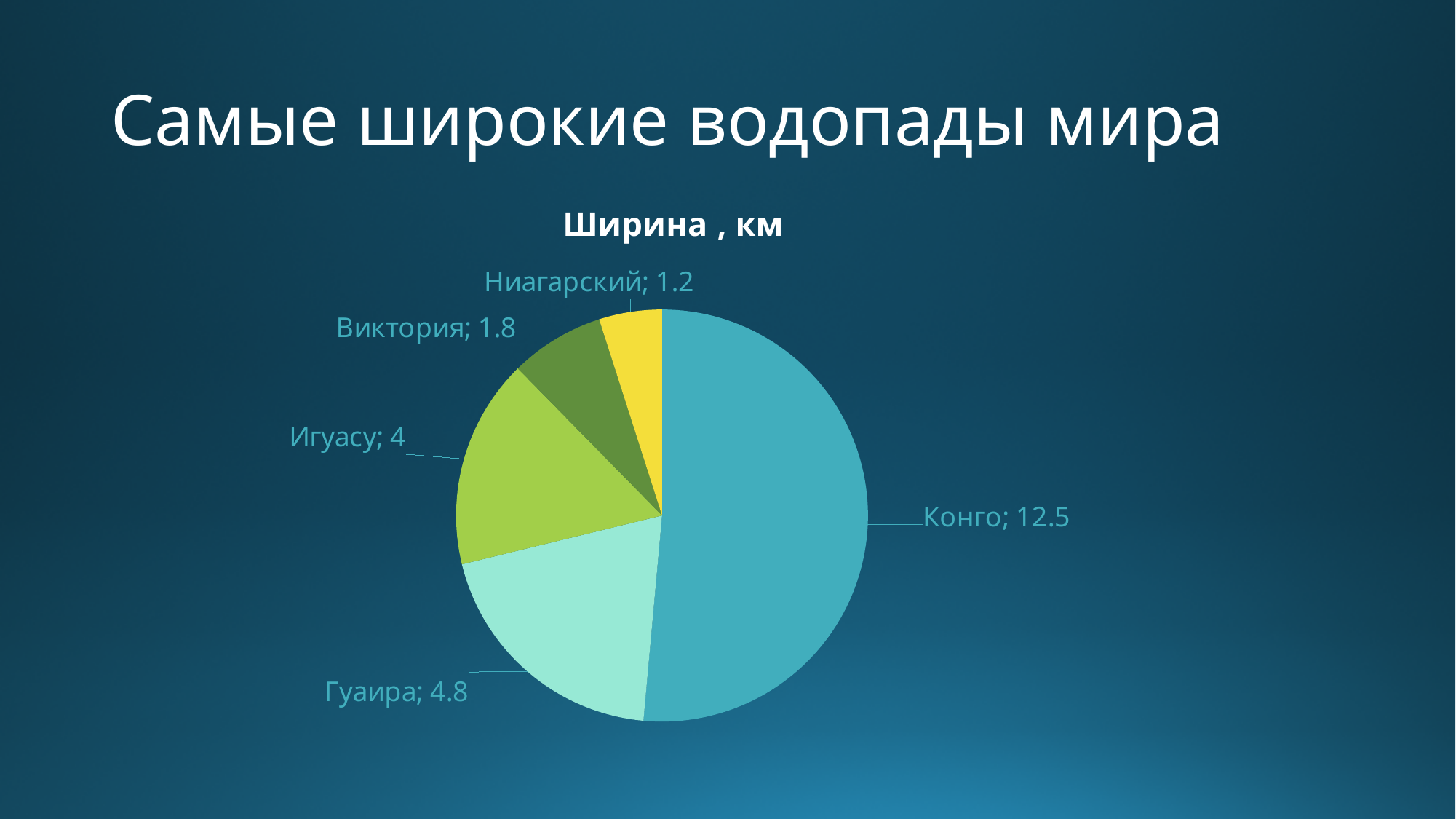
What is the width value shown for Виктория? 1.8 Which waterfall has the smallest slice in the pie chart? Ниагарский What type of chart is shown on the slide? Pie chart What is the title of the chart? Ширина , км What is the width value shown for Гуаира? 4.8 How many waterfalls are shown in the pie chart? 5 What is the difference between the values for Игуасу and Виктория? 2.2 What is the difference between the values for Конго and Гуаира? 7.7 Which waterfall has the largest slice in the pie chart? Конго What is the width value shown for Конго? 12.5 What is the width value shown for Ниагарский? 1.2 Which is larger, the value for Гуаира or the value for Игуасу? Гуаира